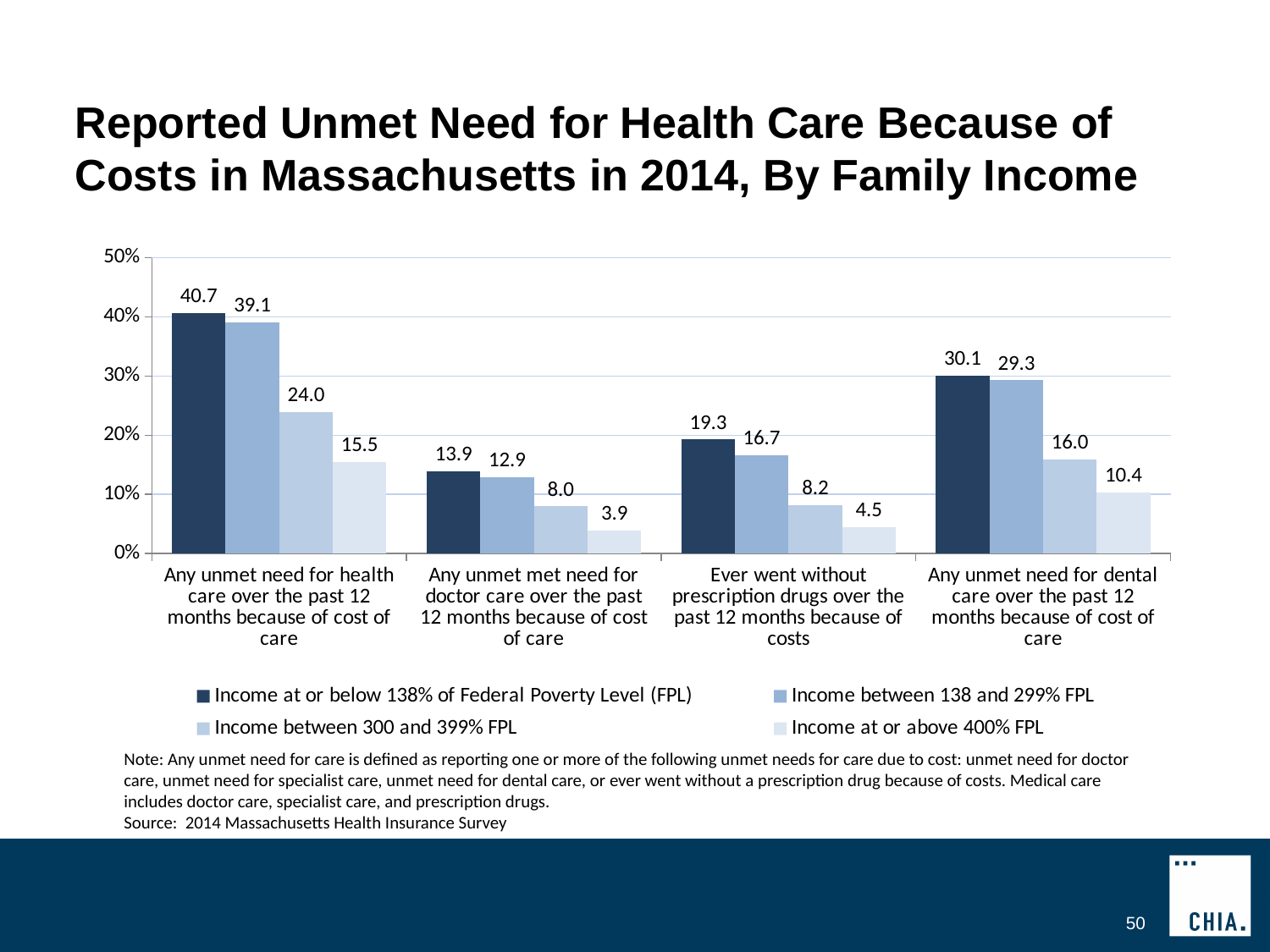
Which category has the highest value for the 'Income between 138 and 299% FPL' series? Any unmet need for health care over the past 12 months because of cost of care What is the value for 'Income between 300 and 399% FPL' in the 'Any unmet need for dental care over the past 12 months because of cost of care' category? 16.0 What is the difference between the 'Income at or below 138% of Federal Poverty Level (FPL)' and 'Income at or above 400% FPL' values in the 'Any unmet need for dental care over the past 12 months because of cost of care' category? 19.7 What is the value for 'Income at or below 138% of Federal Poverty Level (FPL)' in the 'Any unmet need for health care over the past 12 months because of cost of care' category? 40.7 What is the value for 'Income at or above 400% FPL' in the 'Ever went without prescription drugs over the past 12 months because of costs' category? 4.5 How many series does the legend list? 4 What is the title of the chart? Reported Unmet Need for Health Care Because of Costs in Massachusetts in 2014, By Family Income Which category has the lowest value for the 'Income at or above 400% FPL' series? Any unmet met need for doctor care over the past 12 months because of cost of care Is the value for 'Income between 300 and 399% FPL' in the 'Any unmet need for health care over the past 12 months because of cost of care' category greater or less than 20%? greater Which is larger in the 'Ever went without prescription drugs over the past 12 months because of costs' category: the value for 'Income between 300 and 399% FPL' or the value for 'Income at or above 400% FPL'? Income between 300 and 399% FPL What kind of chart is shown on the slide? bar chart How many categories are shown on the x axis? 4